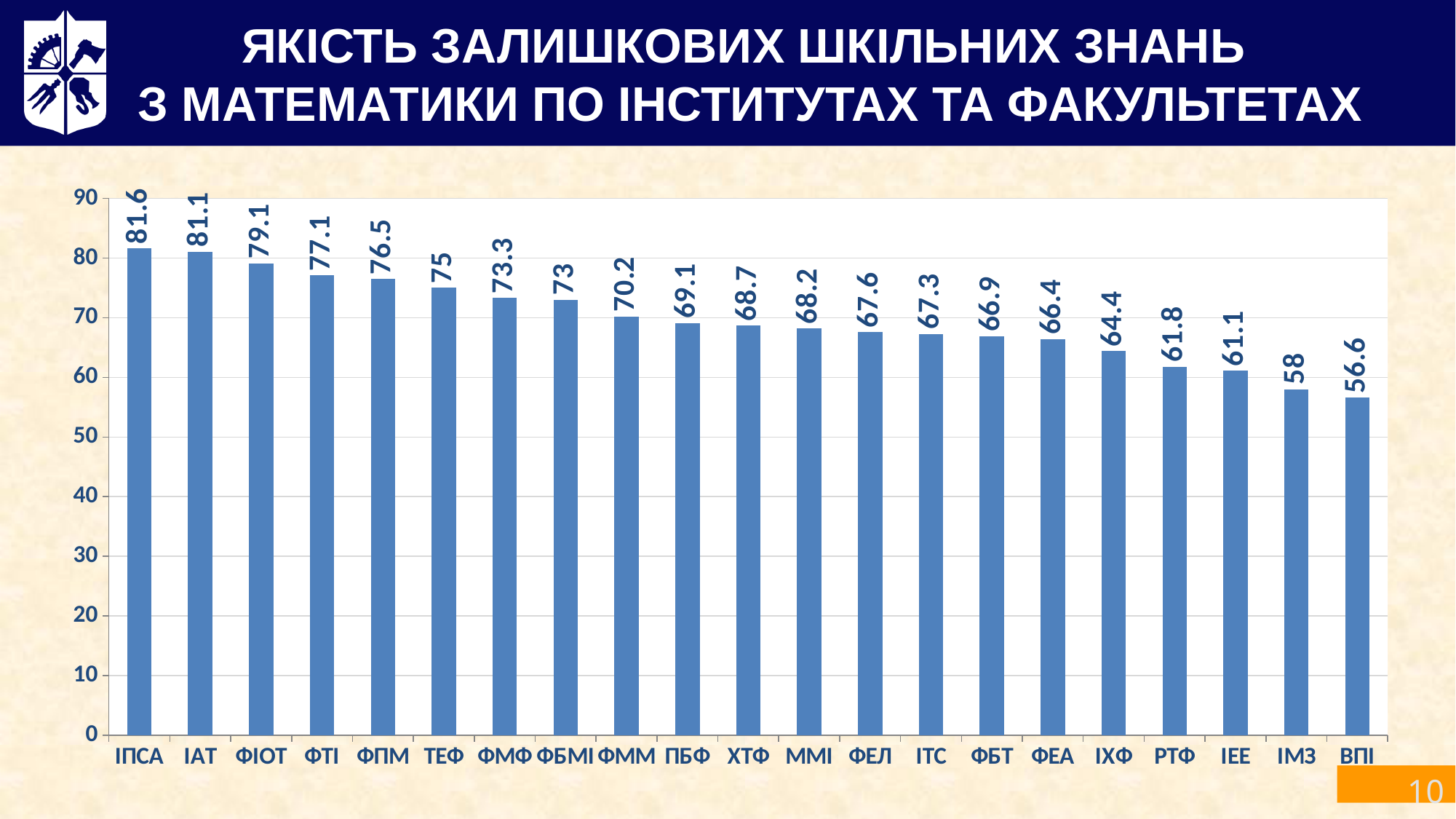
What is the difference between the values for ІПСА and ВПІ? 25 Which institute/faculty has the highest value in the chart? ІПСА Is the value for ІЕЕ greater or less than 70? less Which has a larger value, ФПМ or РТФ? ФПМ How many institutes/faculties are shown on the x axis of the chart? 21 What is the value for ФІОТ? 79.1 Which institute/faculty has the lowest value in the chart? ВПІ What type of chart is shown on the slide? bar chart What is the difference between the values for ТЕФ and ФБМІ? 2 Do the values rise or fall from left to right along the x axis? fall What is the value for ІМЗ? 58 What is the value for ХТФ? 68.7